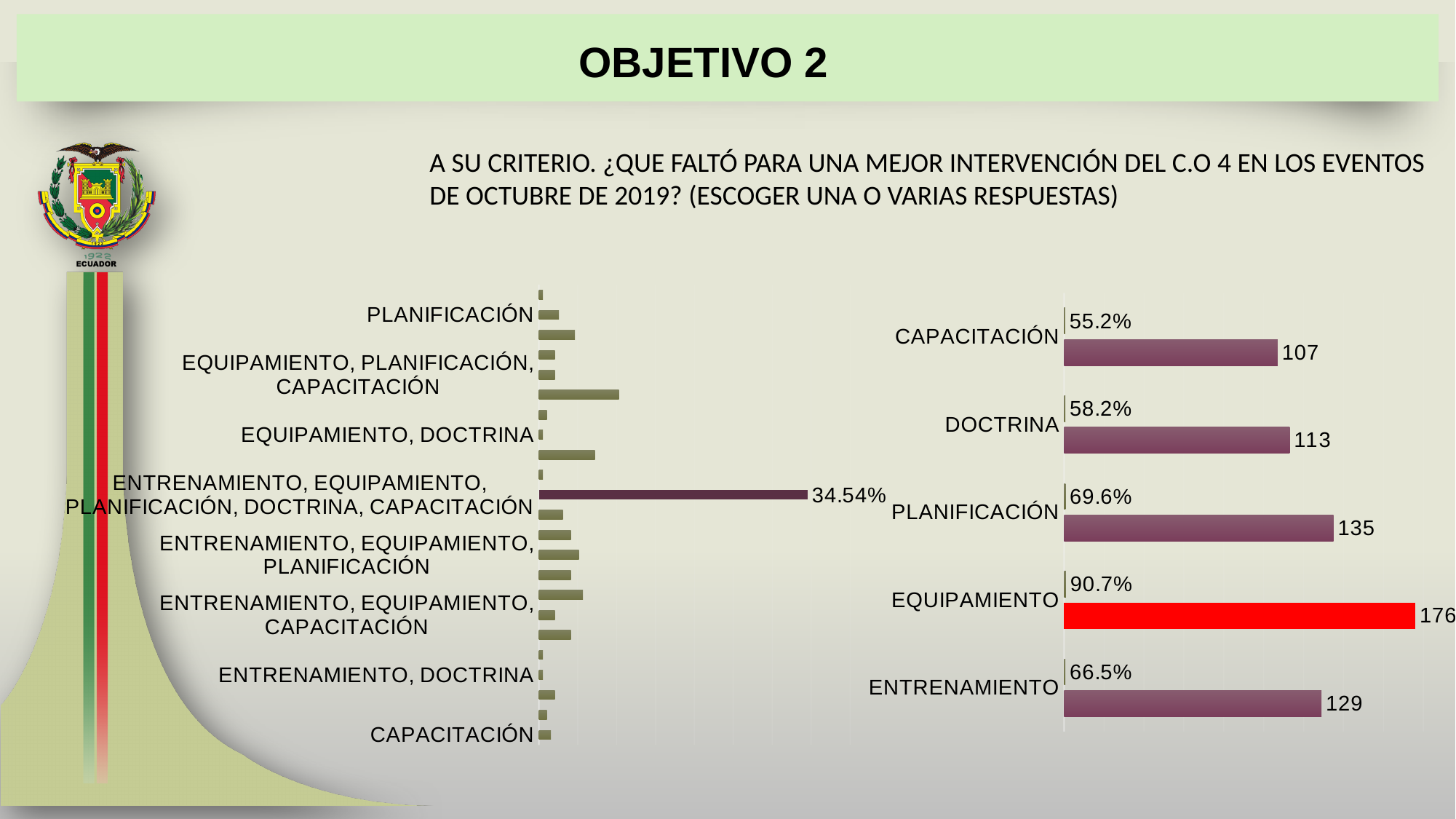
What type of chart is the right-hand chart? Bar chart In the right-hand chart, which category has the highest count? EQUIPAMIENTO How many categories are shown in the right-hand chart? 5 In the left-hand chart, what percentage is labelled for ENTRENAMIENTO, EQUIPAMIENTO, PLANIFICACIÓN, DOCTRINA, CAPACITACIÓN? 34.54% In the right-hand chart, which category has the lowest count? CAPACITACIÓN In the right-hand chart, what count is shown for DOCTRINA? 113 In the right-hand chart, which has a larger count, DOCTRINA or ENTRENAMIENTO? ENTRENAMIENTO In the right-hand chart, what percentage is shown for CAPACITACIÓN? 55.2% In the right-hand chart, which category's bar is coloured red? EQUIPAMIENTO In the right-hand chart, what count is shown for EQUIPAMIENTO? 176 In the right-hand chart, what is the difference between the counts for EQUIPAMIENTO and PLANIFICACIÓN? 41 In the right-hand chart, what percentage is shown for ENTRENAMIENTO? 66.5%